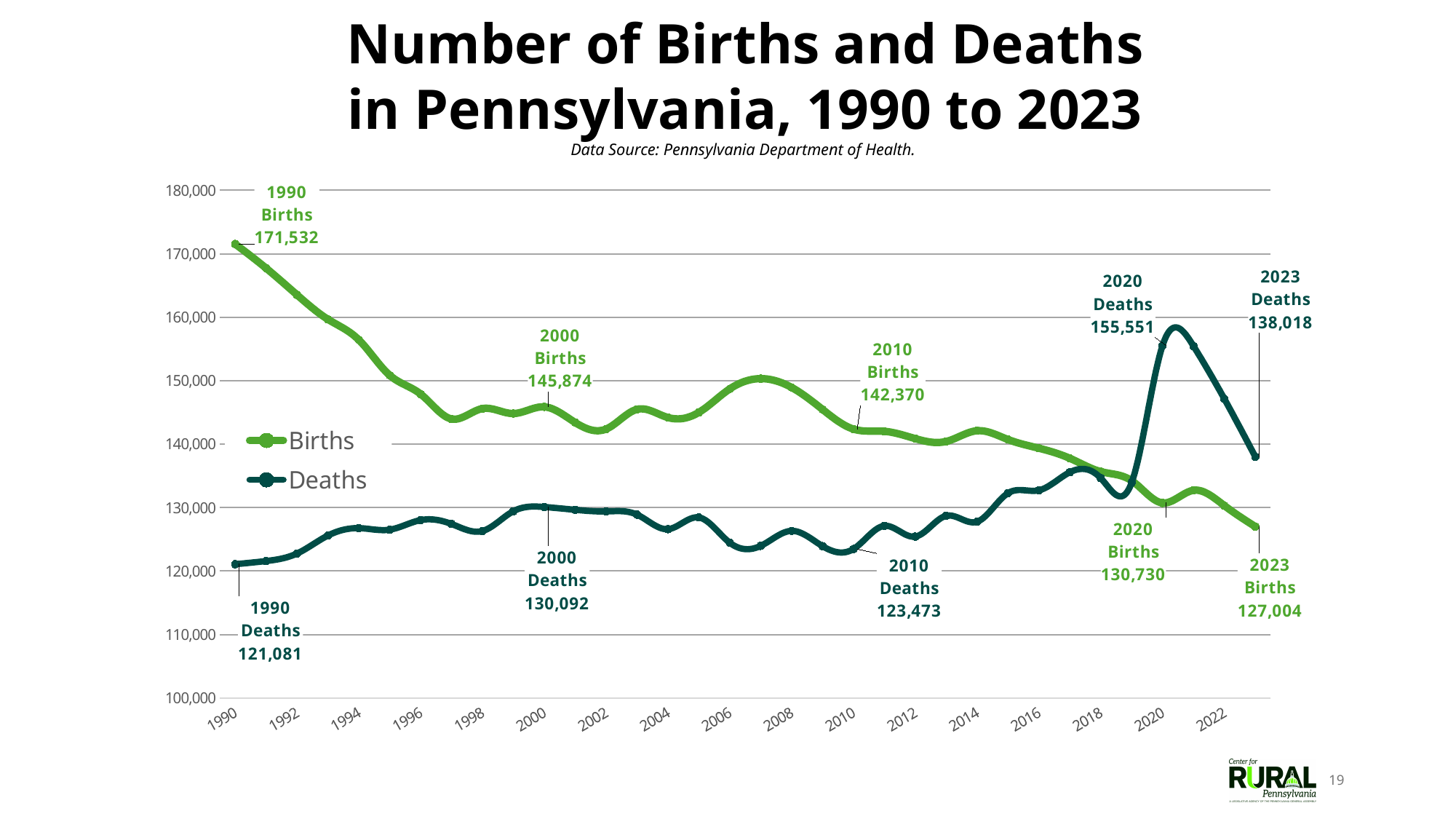
Is the number of deaths in 2016 greater or less than 140,000? less What was the number of deaths in 2010? 123,473 Which was larger in 2020, births or deaths? Deaths By how much did deaths exceed births in 2023? 11,014 What was the number of births in 2023? 127,004 What kind of chart is shown on the slide? line chart What is the difference between births and deaths in 1990? 50,451 What was the number of births in Pennsylvania in 1990? 171,532 How many series does the legend list? 2 In which year were births highest? 1990 What was the number of deaths in Pennsylvania in 2020? 155,551 Do births generally rise or fall from 1990 to 2023? fall